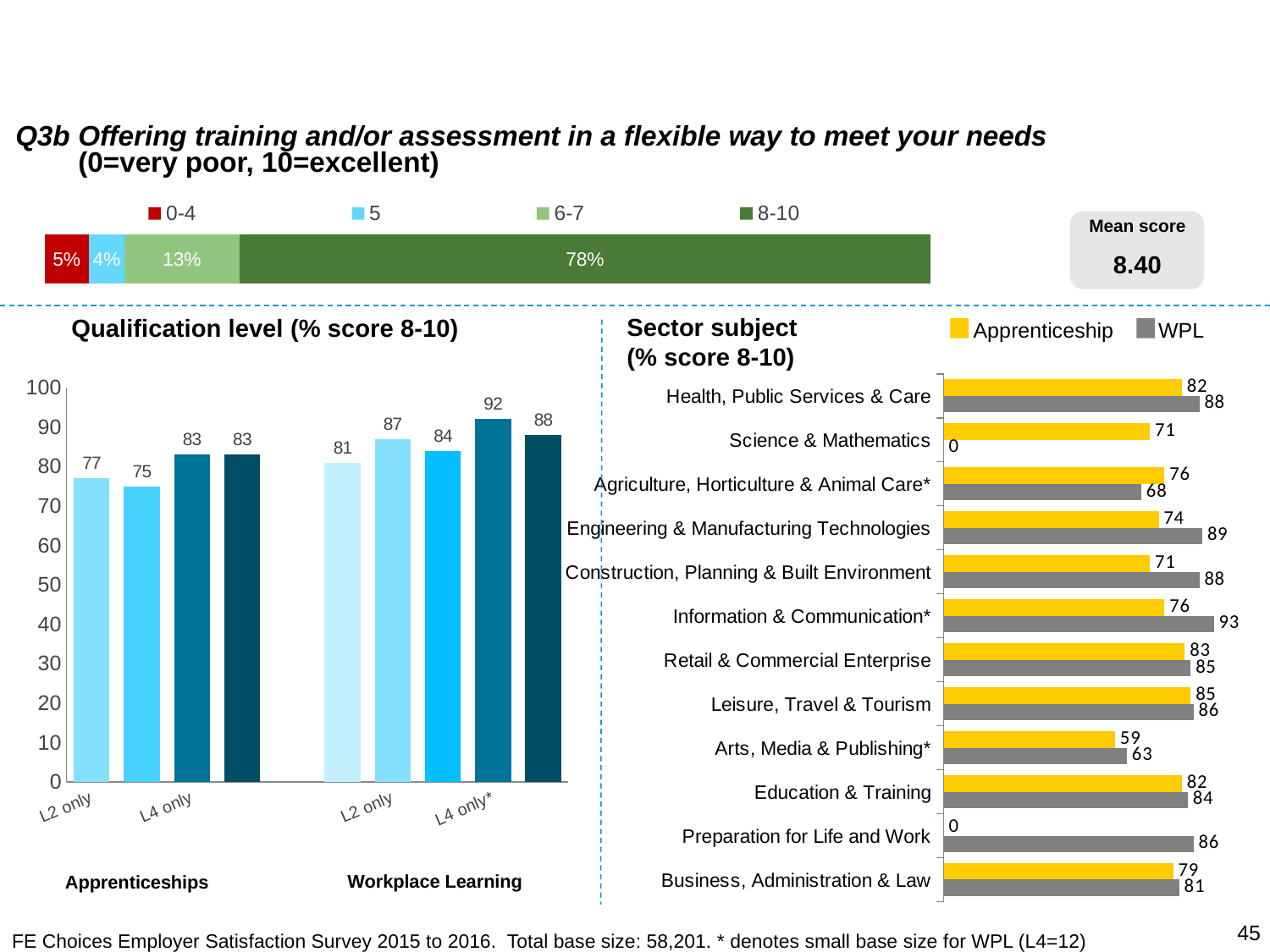
In the Qualification level chart, what is the highest value shown? 92 In the Sector subject chart, what is the Apprenticeship value for Arts, Media & Publishing*? 59 In the Qualification level chart, how many bars are plotted? 9 In the stacked bar at the top of the slide, what percentage gave a score of 0-4? 5% In the Sector subject chart, what is the WPL value for Information & Communication*? 93 In the Sector subject chart, what is the difference between the WPL and Apprenticeship values for Engineering & Manufacturing Technologies? 15 In the Sector subject chart, how many sector subjects are listed? 12 In the stacked bar at the top of the slide, what percentage of employers gave a score of 8-10? 78% In the stacked bar at the top of the slide, how many score bands does the legend list? 4 What is the mean score shown on the slide? 8.40 In the Qualification level chart, what is the lowest value shown? 75 What kind of chart is the Qualification level chart? bar chart